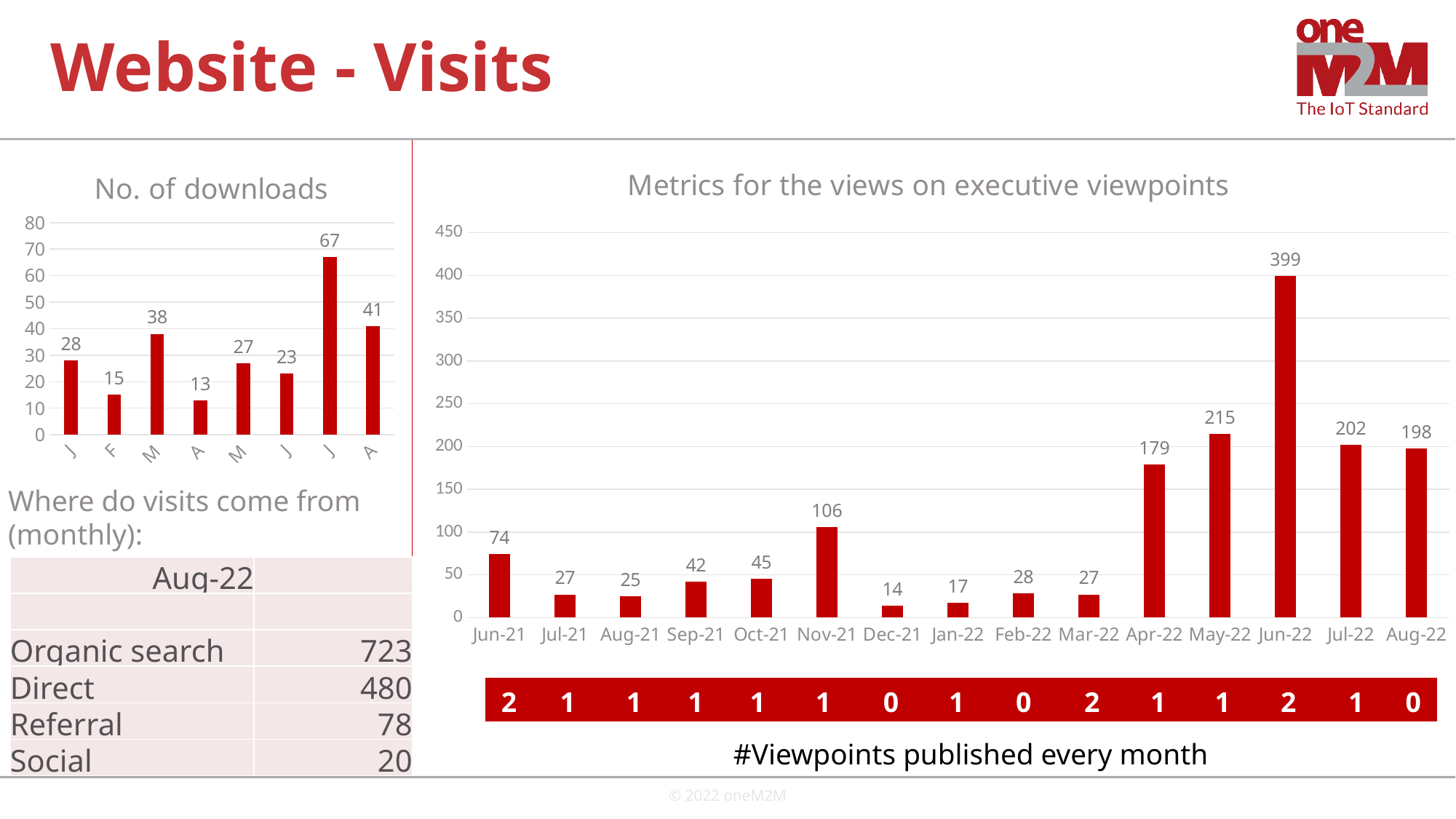
In the 'Metrics for the views on executive viewpoints' chart, what is the difference between the values for May-22 and Apr-22? 36 In the 'No. of downloads' chart, what is the difference between the last bar (41) and the first bar (28)? 13 In the 'Metrics for the views on executive viewpoints' chart, which month has the highest value? Jun-22 How many months are shown on the x axis of the 'Metrics for the views on executive viewpoints' chart? 15 In the 'No. of downloads' chart, what is the lowest value shown? 13 What type of chart is 'Metrics for the views on executive viewpoints'? bar chart In the 'Metrics for the views on executive viewpoints' chart, which is larger, the value for Jul-22 or Aug-22? Jul-22 In the 'Metrics for the views on executive viewpoints' chart, which month has the lowest value? Dec-21 How many bars are in the 'No. of downloads' chart? 8 In the 'Metrics for the views on executive viewpoints' chart, what is the value for Jun-22? 399 In the 'No. of downloads' chart, what is the highest value shown? 67 In the 'Metrics for the views on executive viewpoints' chart, what is the value for Nov-21? 106